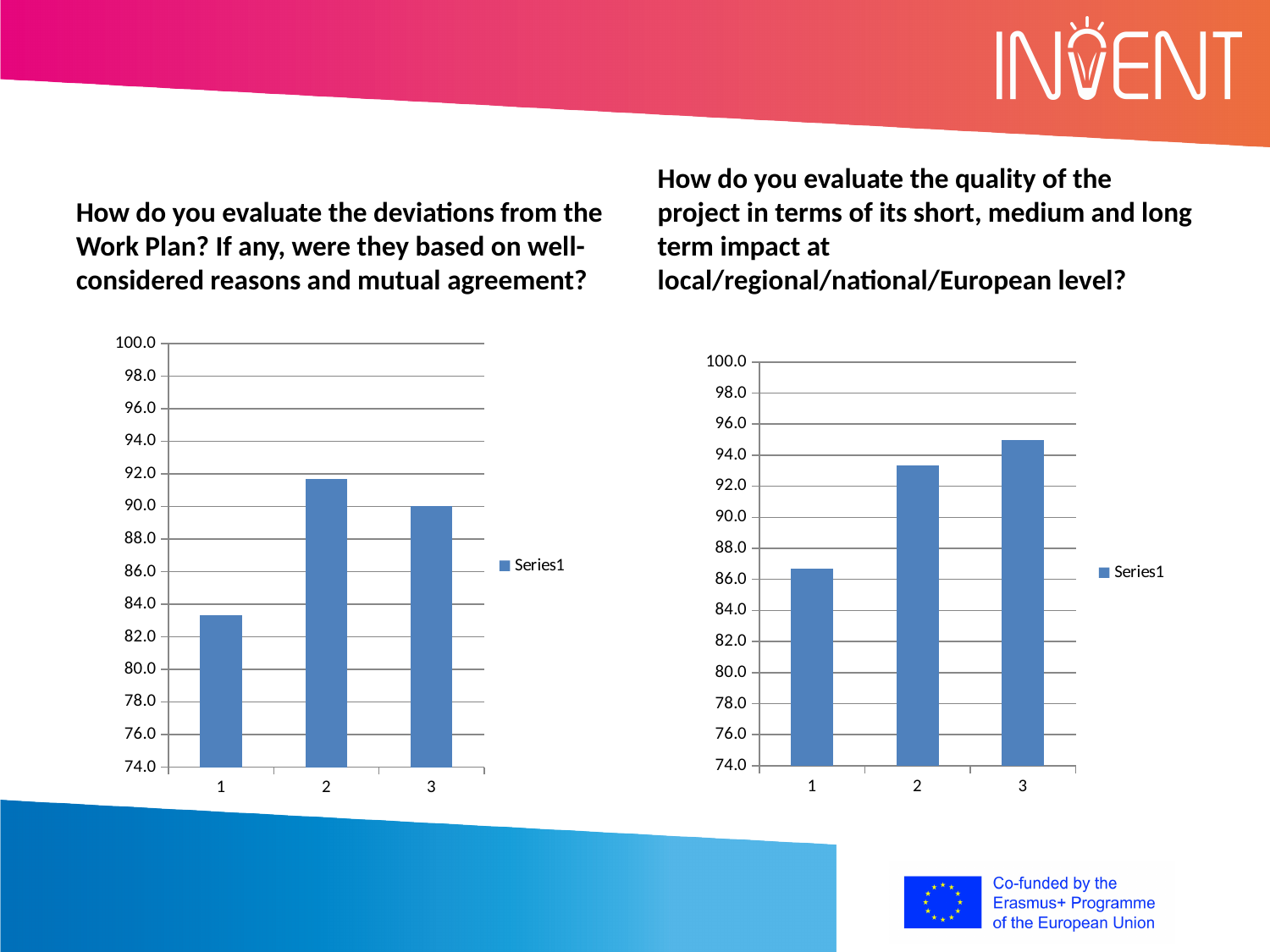
How many categories are shown on the x axis of the left chart? 3 In the right chart, do the values rise or fall from category 1 to category 3? rise How many series does the legend of the right chart list? 1 In the left chart, which category has the lowest bar? 1 In the left chart, is the value for category 2 greater or less than 90.0? greater In the right chart, is the value for category 3 greater or less than 94.0? greater In the right chart, which category has the highest bar? 3 In the right chart, which category has the lowest bar? 1 In the right chart, is the value for category 1 greater or less than 88.0? less What kind of chart is the left chart on the slide? bar chart In the left chart, which category has the highest bar? 2